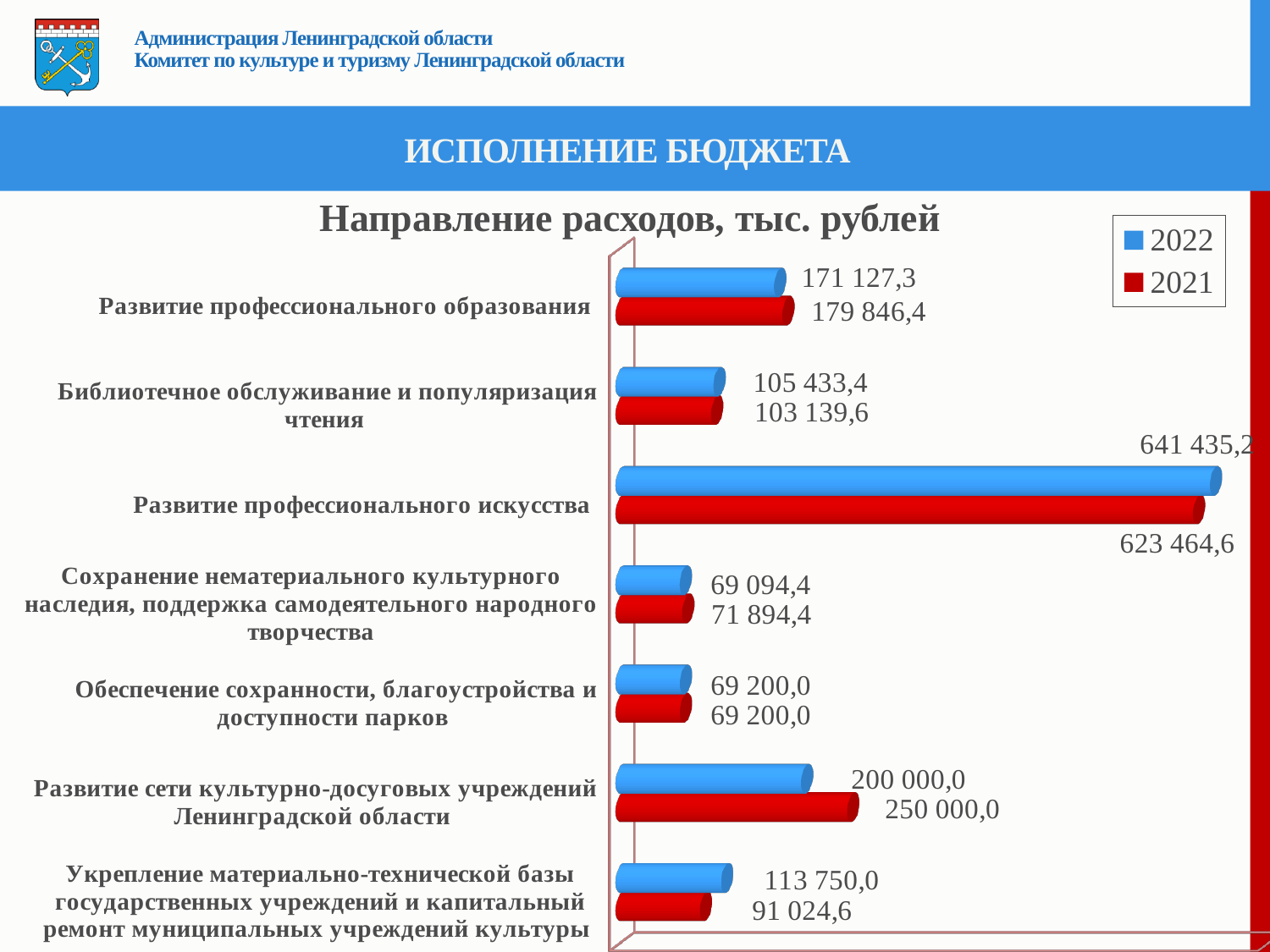
Which category has the highest 2022 value? Развитие профессионального искусства What is the difference between the 2021 and 2022 values for Развитие сети культурно-досуговых учреждений Ленинградской области? 50 000,0 What type of chart is shown on the slide? Bar chart Which category has the lowest 2022 value? Сохранение нематериального культурного наследия, поддержка самодеятельного народного творчества How many series does the legend list? 2 For Развитие профессионального образования, which year has the larger value, 2022 or 2021? 2021 How many categories are shown in the chart? 7 What is the 2021 value for Библиотечное обслуживание и популяризация чтения? 103 139,6 What is the 2022 value for Развитие профессионального искусства? 641 435,2 What is the difference between the 2022 and 2021 values for Развитие профессионального искусства? 17 970,6 What is the 2022 value for Укрепление материально-технической базы государственных учреждений и капитальный ремонт муниципальных учреждений культуры? 113 750,0 What is the 2021 value for Развитие сети культурно-досуговых учреждений Ленинградской области? 250 000,0